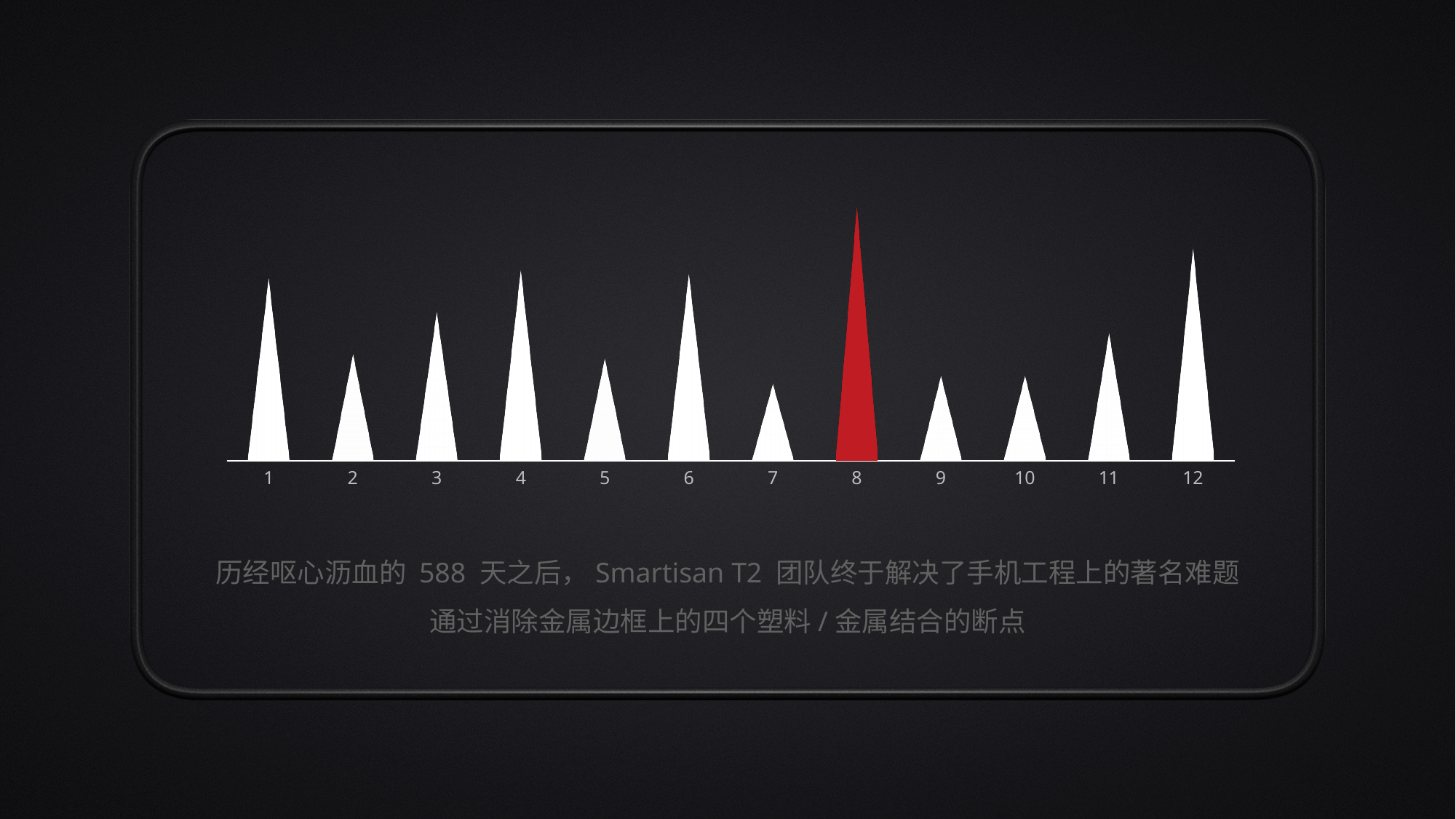
Which is larger, the value for category 10 or category 11? 11 Which is larger, the value for category 1 or category 2? 1 Which is larger, the value for category 3 or category 5? 3 What kind of chart is shown on the slide? bar chart What is the label of the last category on the x axis? 12 Which category has the highest value? 8 Which category is drawn in red rather than white? 8 How many categories are shown on the x axis? 12